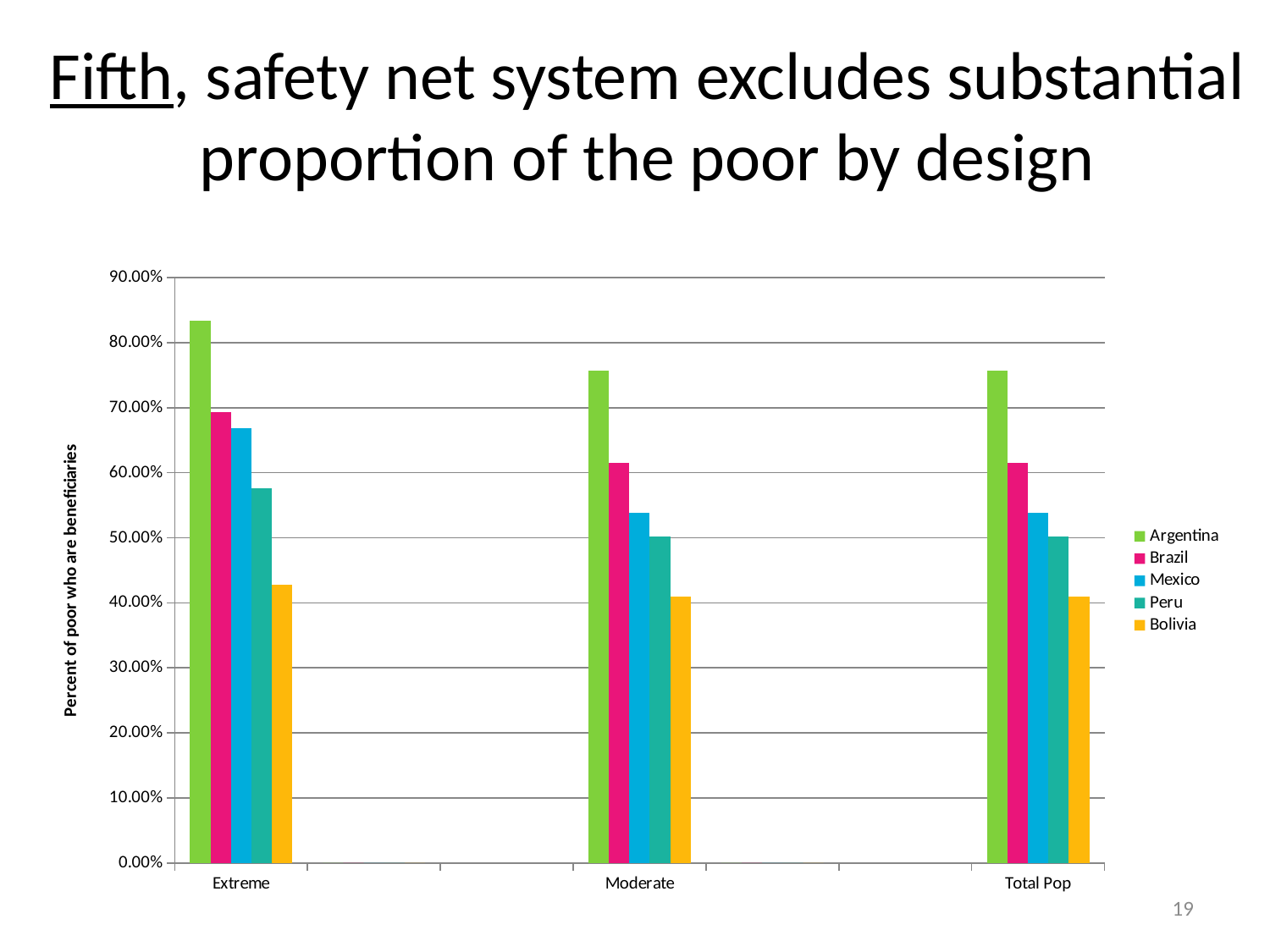
Which is larger, the value for Brazil or the value for Peru in the Extreme category? Brazil Is the value for Peru in the Moderate category greater or less than 60.00%? less What kind of chart is shown on the slide? bar chart Which country has the lowest value in the Moderate category? Bolivia Is the value for Argentina in the Extreme category greater or less than 80.00%? greater Is the value for Brazil in the Total Pop category greater or less than 60.00%? greater Which country has the highest value in the Extreme category? Argentina How many series does the legend list? 5 Does the value for Argentina rise or fall from the Extreme category to the Moderate category? fall What is the label of the y axis? Percent of poor who are beneficiaries How many categories are shown on the x axis? 3